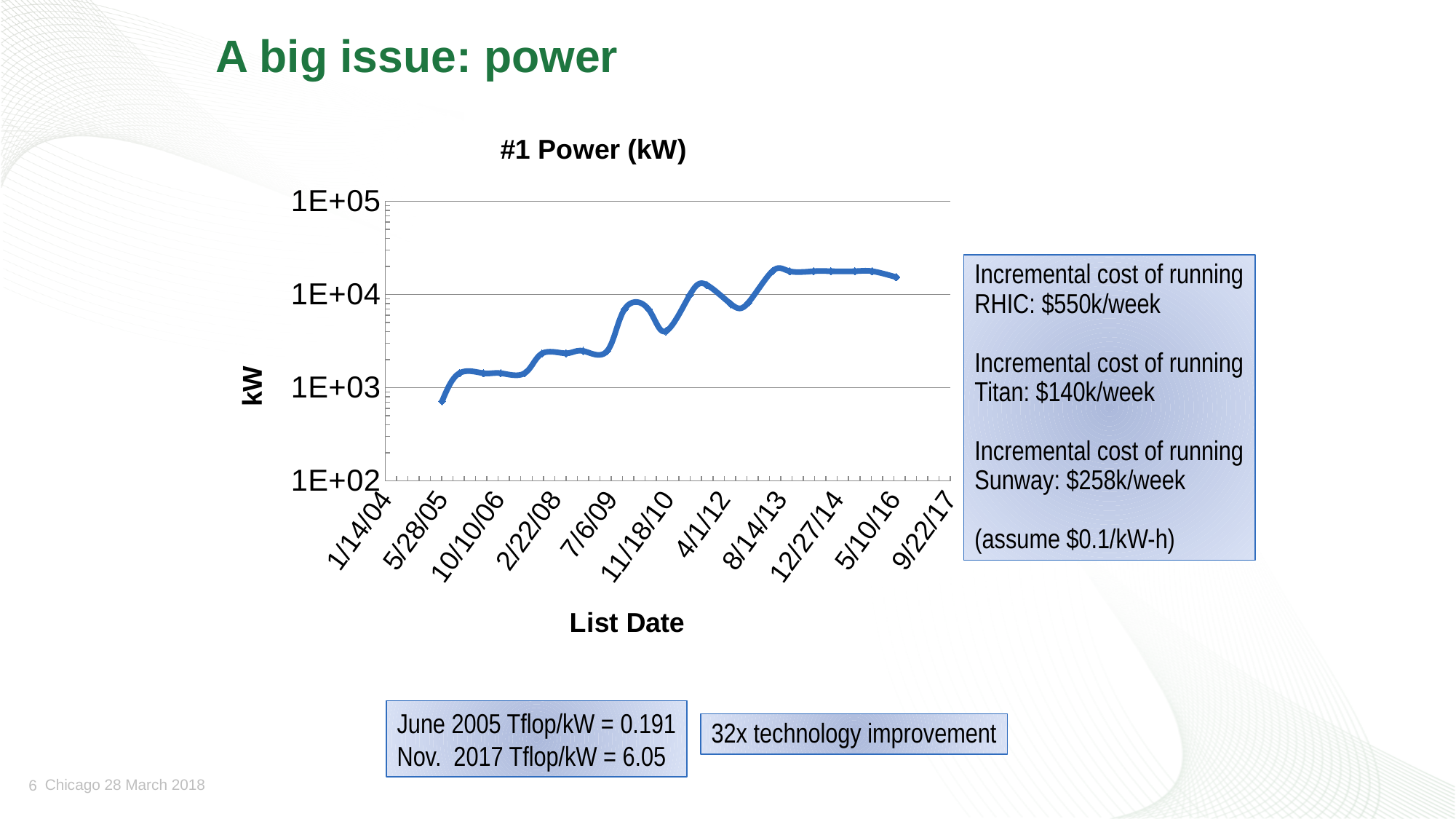
Is the value plotted near 5/28/05 greater or less than 1E+03? less Is the value plotted near 5/10/16 greater or less than 1E+04? greater Is the value plotted near 10/10/06 greater or less than 1E+03? greater What is the title of the chart? #1 Power (kW) What is the label of the x axis of the chart? List Date Overall, do the plotted power values rise or fall from left to right along the x axis? rise Which is larger, the value plotted near 8/14/13 or the value plotted near 5/28/05? 8/14/13 What kind of chart is shown on the slide? line chart Near which x-axis date does the line reach its lowest value? 5/28/05